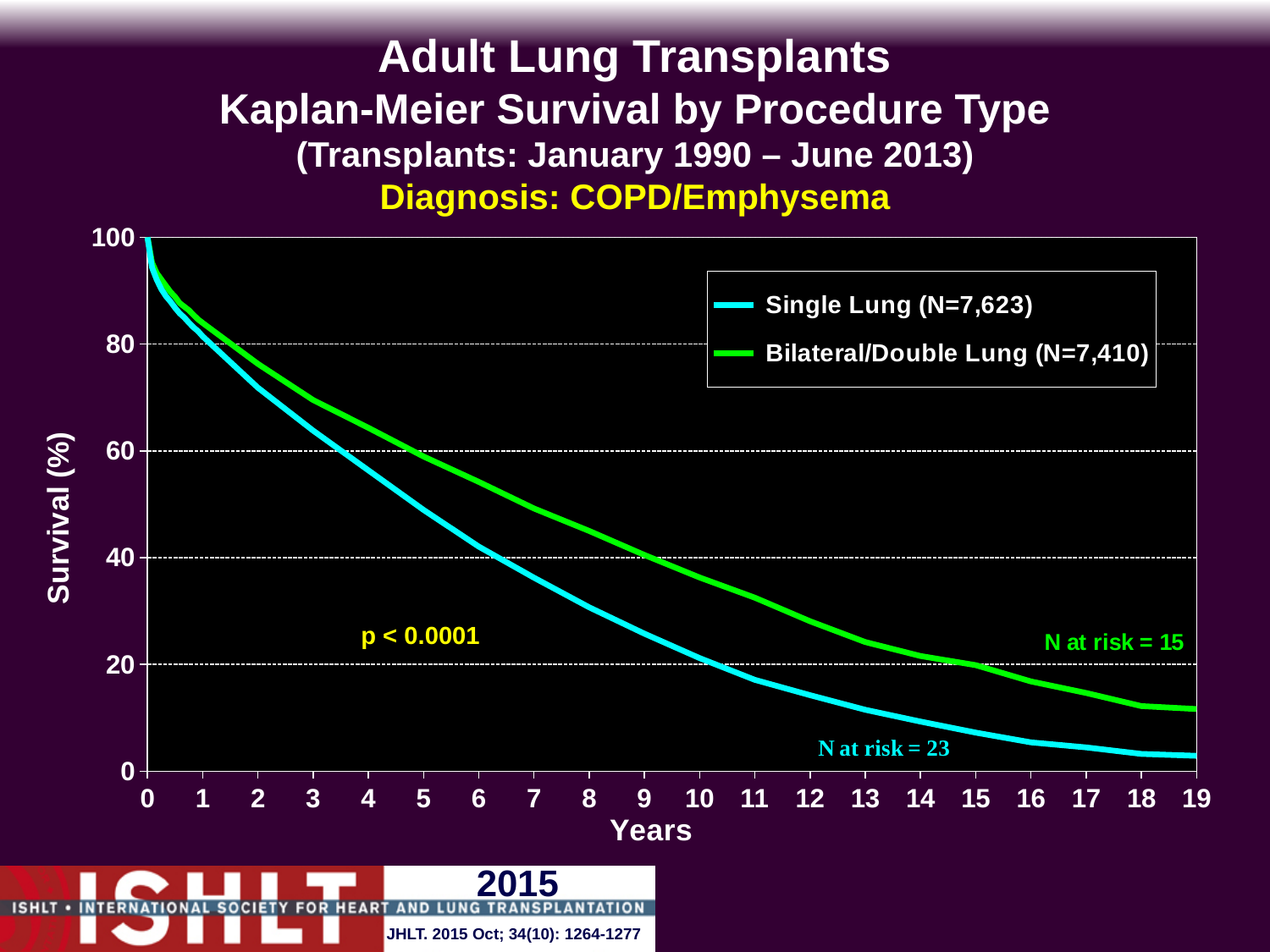
What is the N at risk value shown for the Single Lung curve at the end of follow-up? 23 At 10 years, which series has the higher survival: Single Lung or Bilateral/Double Lung? Bilateral/Double Lung Do the survival curves rise or fall as years increase? fall Is the survival for Single Lung at 15 years greater or less than 20? less Is the survival for Bilateral/Double Lung at 3 years greater or less than 60? greater What is the N at risk value shown for the Bilateral/Double Lung curve at the end of follow-up? 15 How many series does the legend list? 2 What is the N for the Single Lung series shown in the legend? 7,623 What kind of chart is shown on the slide? line chart What p-value is printed on the chart? p < 0.0001 Is the survival for Single Lung at 5 years greater or less than 60? less What is the N for the Bilateral/Double Lung series shown in the legend? 7,410